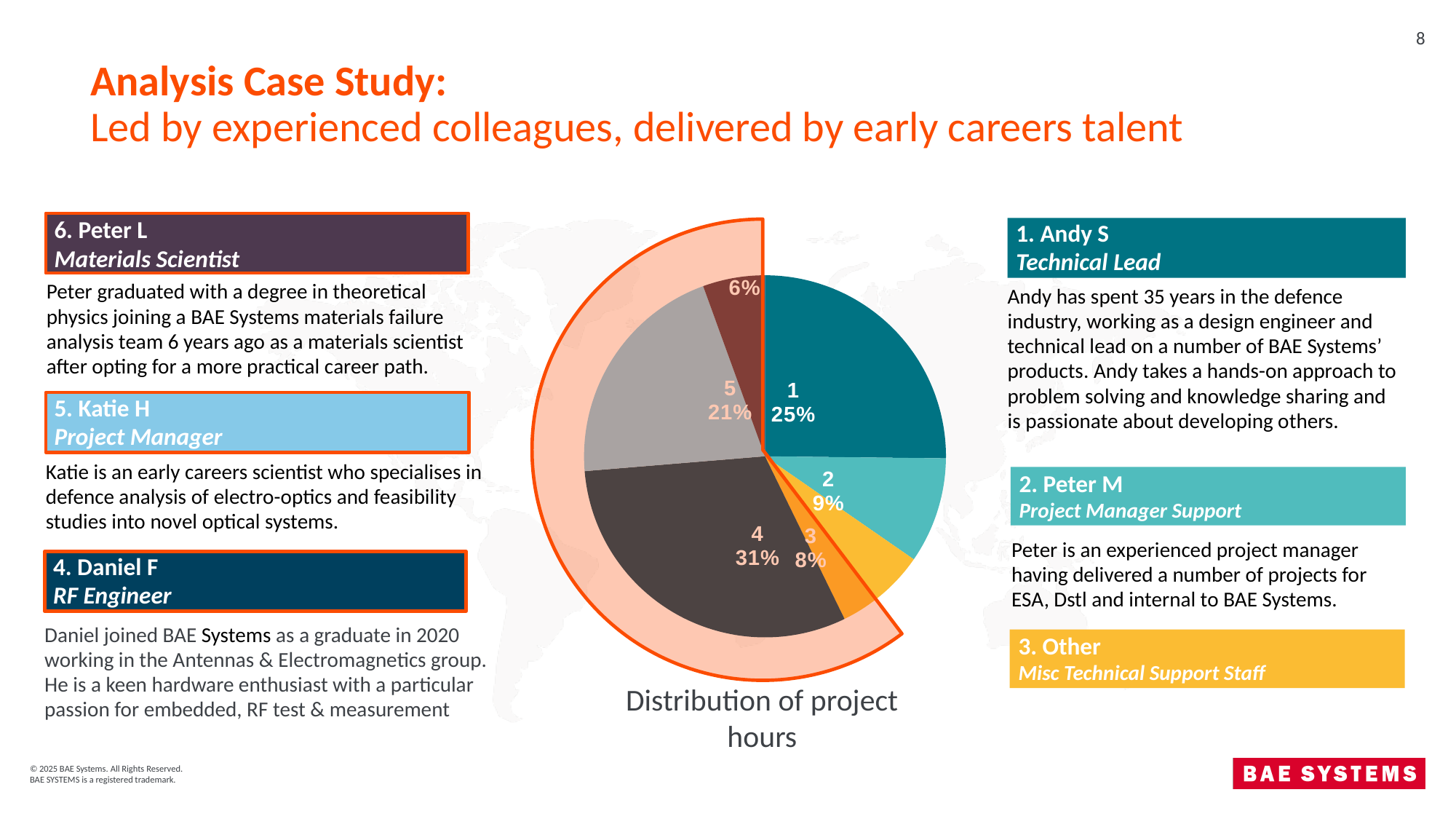
How many slices does the pie chart have? 6 Which slice of the pie chart is the smallest? 6 What is the difference in percentage points between slice 4 and slice 1? 6 What percentage of project hours is attributed to slice 3, labelled 'Other' on the slide? 8% What share of project hours does slice 1 represent? 25% What percentage is shown for slice 5 in the pie chart? 21% Which slice of the pie chart is the largest? 4 What is the combined percentage of slices 4 and 5? 52% What percentage is shown for slice 4 in the pie chart? 31% Which is larger, slice 2 or slice 3? slice 2 What kind of chart is shown on the slide? pie chart What is the title of the chart? Distribution of project hours